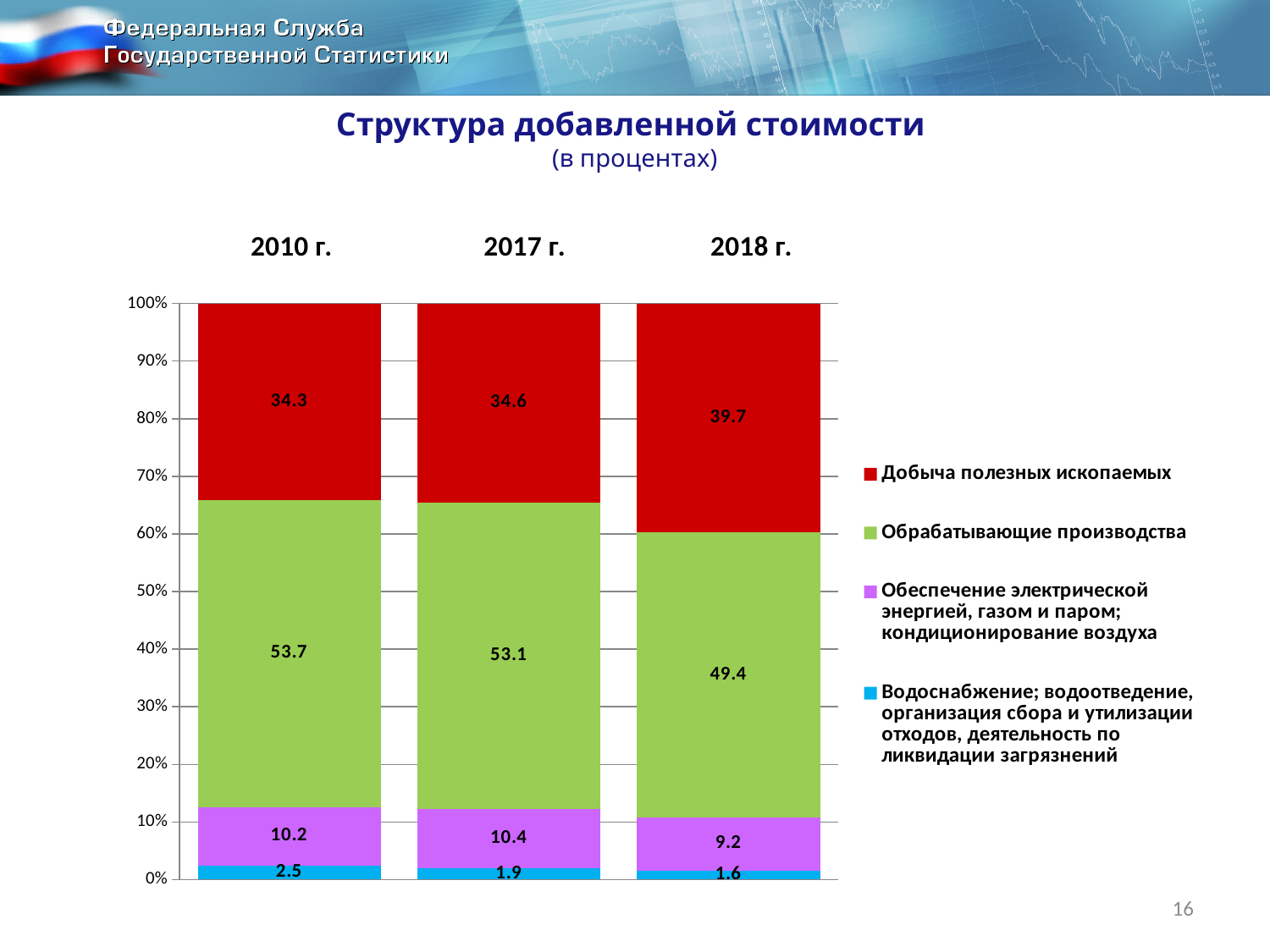
What is the value for Обрабатывающие производства in 2010 г.? 53.7 How many series does the legend list? 4 Which year has the larger value for Обеспечение электрической энергией, газом и паром; кондиционирование воздуха: 2010 г. or 2017 г.? 2017 г. Does the share of Добыча полезных ископаемых rise or fall from 2010 г. to 2018 г.? Rise What is the value for Добыча полезных ископаемых in 2018 г.? 39.7 What is the value for Водоснабжение; водоотведение, организация сбора и утилизации отходов, деятельность по ликвидации загрязнений in 2017 г.? 1.9 In which year is the share of Обрабатывающие производства the lowest? 2018 г. How many years (categories) are shown on the chart? 3 What kind of chart is shown on the slide? Stacked bar chart What is the value for Обеспечение электрической энергией, газом и паром; кондиционирование воздуха in 2018 г.? 9.2 What is the difference between the Обрабатывающие производства values for 2010 г. and 2018 г.? 4.3 In which year is the share of Добыча полезных ископаемых the highest? 2018 г.